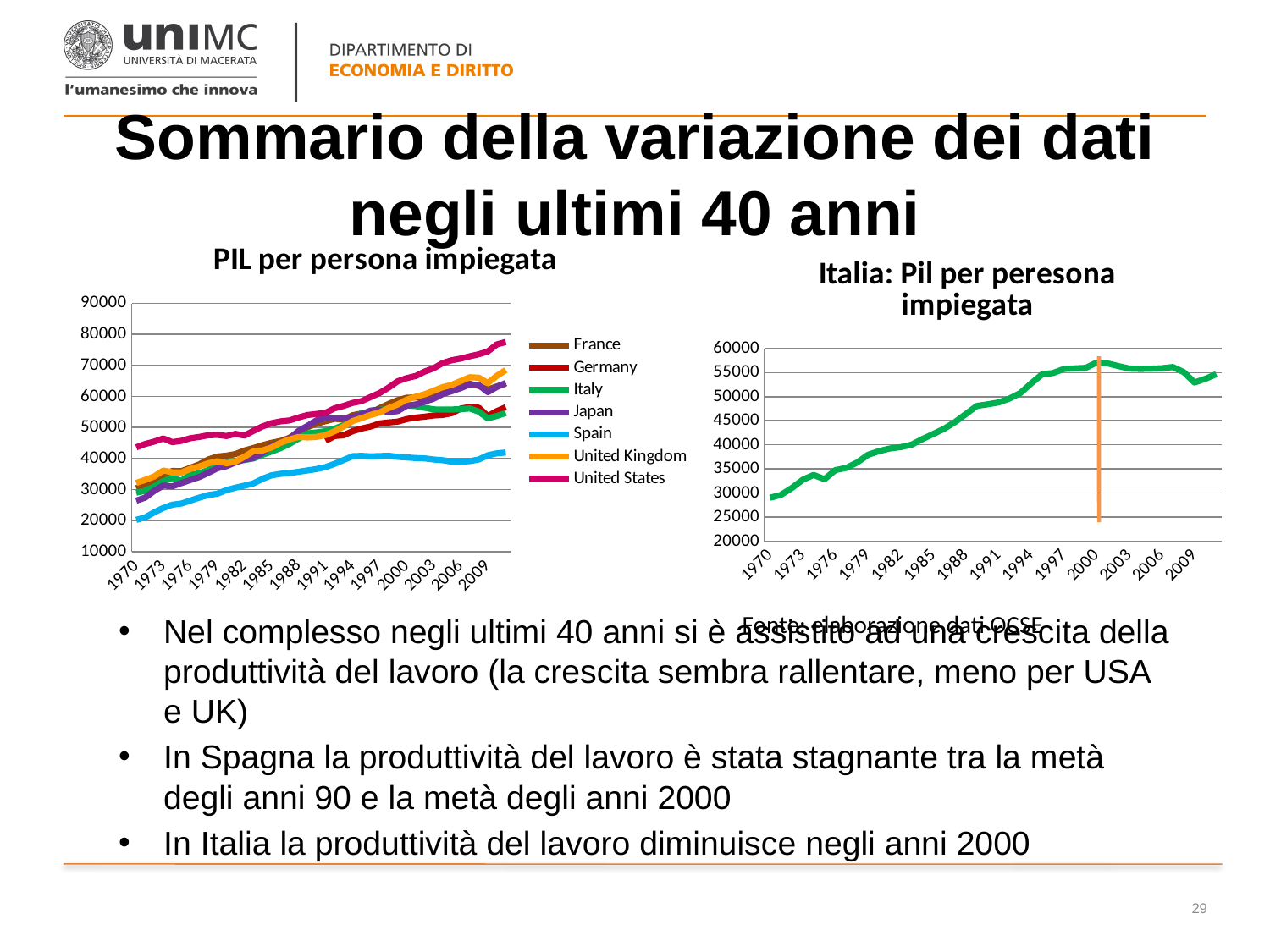
In the 'PIL per persona impiegata' chart, what colour is the line for the United States in the legend? pink In the 'PIL per persona impiegata' chart, is the value for Spain in 1970 greater or less than 30000? less In the 'PIL per persona impiegata' chart, is the value for Spain in 2009 greater or less than 50000? less In the 'PIL per persona impiegata' chart, which country has the highest value in 2009? United States In the 'Italia: Pil per peresona impiegata' chart, do the values rise or fall from 1970 to 1997? rise In the 'PIL per persona impiegata' chart, do the values for the United States rise or fall from 1970 to 2009? rise In the 'Italia: Pil per peresona impiegata' chart, is the value around 2000 greater or less than 55000? greater In the 'PIL per persona impiegata' chart, which is larger in 2009, the value for the United States or the value for Spain? United States What kind of chart is the 'PIL per persona impiegata' chart on the left? line chart In the 'PIL per persona impiegata' chart, which country has the lowest value in 1970? Spain How many series does the legend of the 'PIL per persona impiegata' chart list? 7